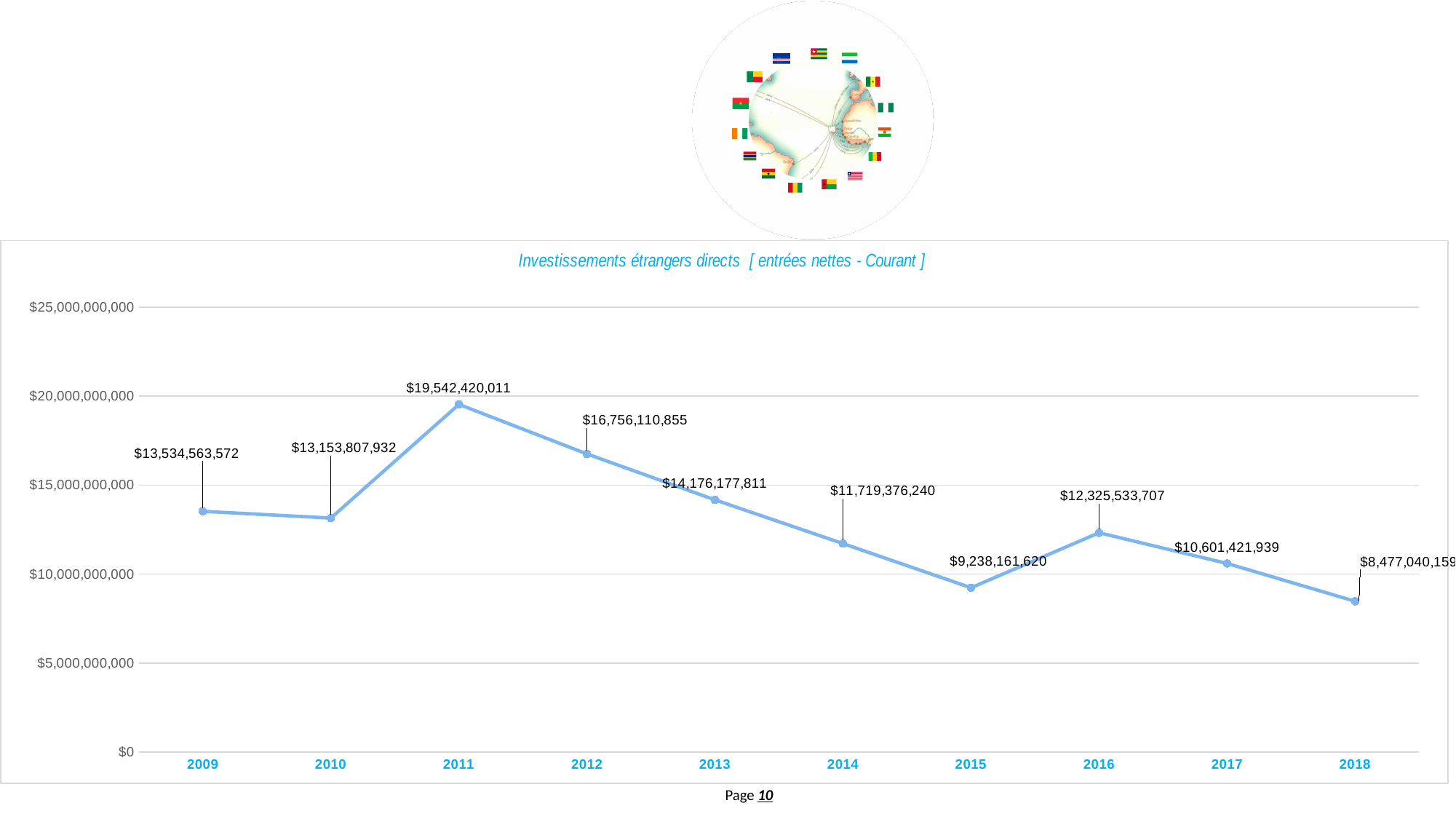
What is the title of the chart? Investissements étrangers directs [ entrées nettes - Courant ] What is the difference between the values for 2009 and 2010? $380,755,640 What kind of chart is shown? line chart Which is larger, the value for 2016 or the value for 2017? 2016 Is the value for 2012 greater or less than $15,000,000,000? greater What is the value for 2011? $19,542,420,011 What is the value for 2018? $8,477,040,159 How many years are plotted on the x axis? 10 Which year has the lowest value? 2018 Which year has the highest value? 2011 What is the difference between the values for 2011 and 2018? $11,065,379,852 What is the value for 2015? $9,238,161,620